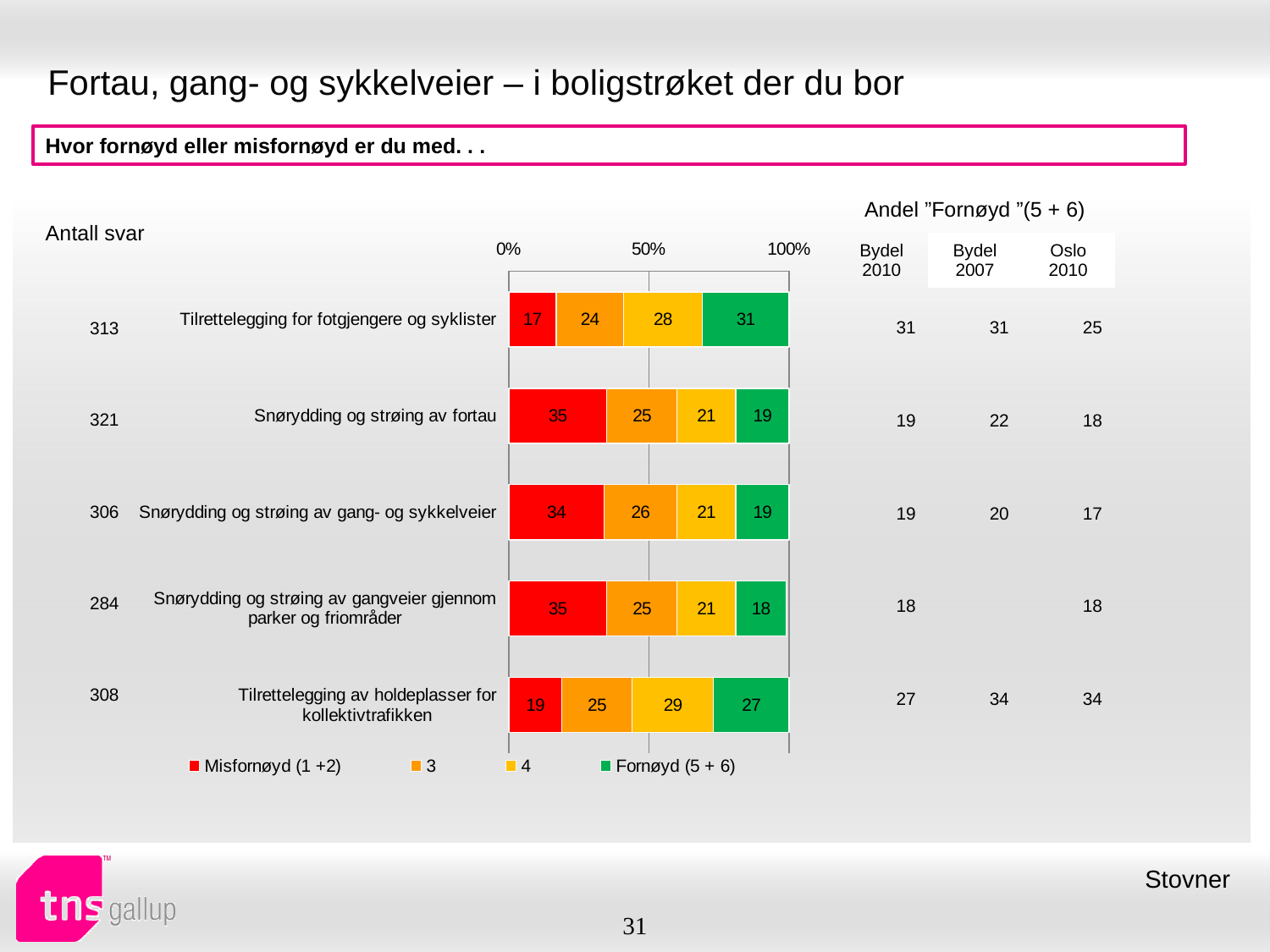
Which is larger: the Fornøyd (5 + 6) value for Tilrettelegging av holdeplasser for kollektivtrafikken or for Snørydding og strøing av fortau? Tilrettelegging av holdeplasser for kollektivtrafikken How many series does the legend list? 4 What kind of chart is shown on the slide? bar chart Which colour represents the Fornøyd (5 + 6) series in the chart? green What is the value of series 4 for Tilrettelegging av holdeplasser for kollektivtrafikken? 29 What is the value of series 3 for Snørydding og strøing av gang- og sykkelveier? 26 Which category has the highest Fornøyd (5 + 6) value? Tilrettelegging for fotgjengere og syklister What is the Fornøyd (5 + 6) value for Tilrettelegging for fotgjengere og syklister? 31 What is the difference between the Misfornøyd (1 +2) value for Snørydding og strøing av fortau and that for Tilrettelegging for fotgjengere og syklister? 18 What is the Misfornøyd (1 +2) value for Snørydding og strøing av fortau? 35 How many categories are plotted in the chart? 5 Which category has the lowest Fornøyd (5 + 6) value? Snørydding og strøing av gangveier gjennom parker og friområder